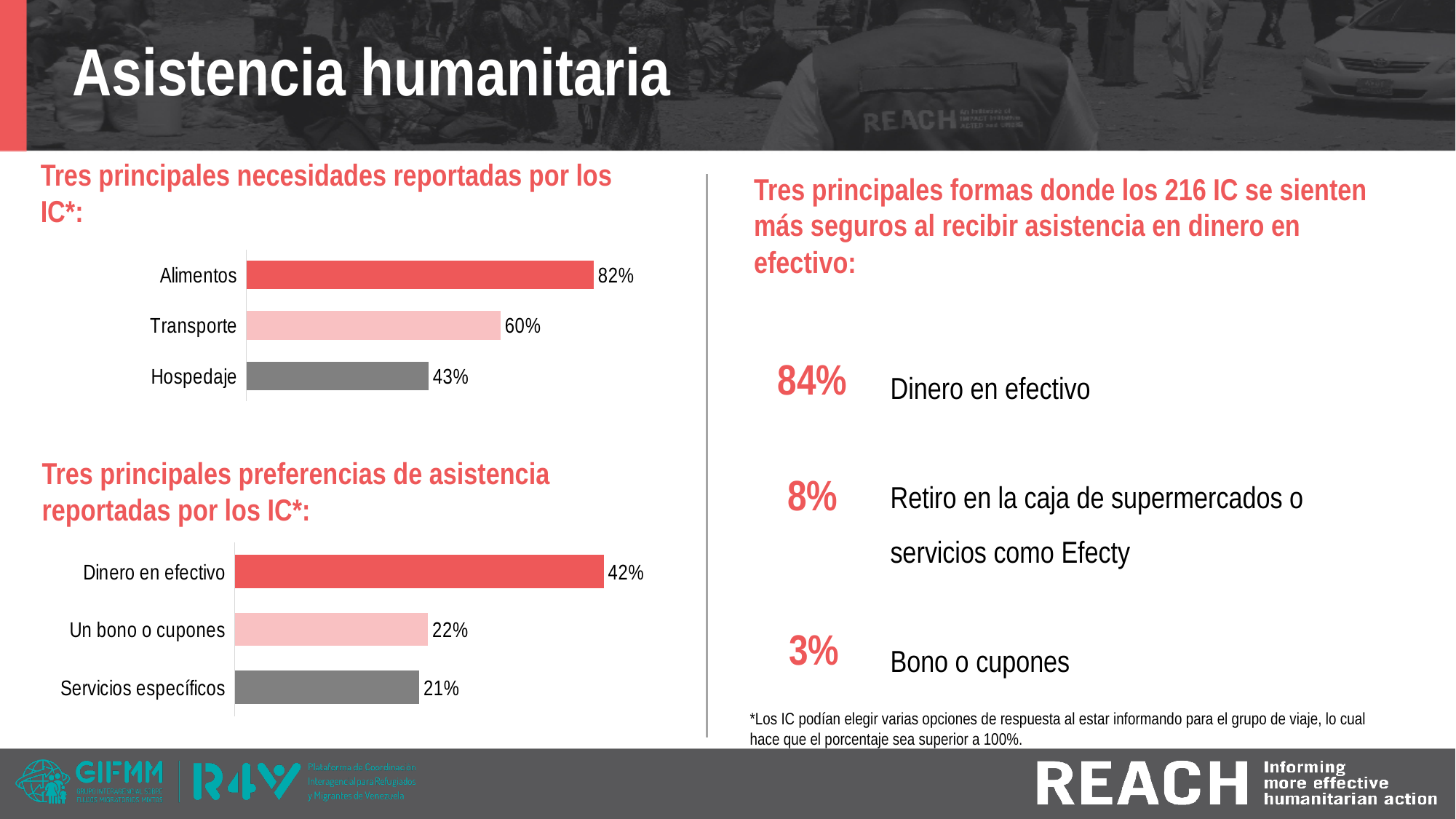
In the chart 'Tres principales preferencias de asistencia reportadas por los IC*', what is the difference between Dinero en efectivo and Un bono o cupones? 20 percentage points In the chart 'Tres principales necesidades reportadas por los IC*', what is the difference between Alimentos and Hospedaje? 39 percentage points In the chart 'Tres principales preferencias de asistencia reportadas por los IC*', which category has the highest value? Dinero en efectivo In the chart 'Tres principales necesidades reportadas por los IC*', what colour is the Alimentos bar? Red In the chart 'Tres principales preferencias de asistencia reportadas por los IC*', which is larger, Dinero en efectivo or Un bono o cupones? Dinero en efectivo In the chart 'Tres principales necesidades reportadas por los IC*', what is the value for Transporte? 60% In the chart 'Tres principales necesidades reportadas por los IC*', what is the value for Alimentos? 82% In the chart 'Tres principales preferencias de asistencia reportadas por los IC*', what is the value for Dinero en efectivo? 42% What type of chart is used for 'Tres principales necesidades reportadas por los IC*'? Bar chart In the chart 'Tres principales necesidades reportadas por los IC*', how many categories are shown? 3 In the chart 'Tres principales necesidades reportadas por los IC*', which category has the lowest value? Hospedaje In the chart 'Tres principales preferencias de asistencia reportadas por los IC*', what is the value for Servicios específicos? 21%